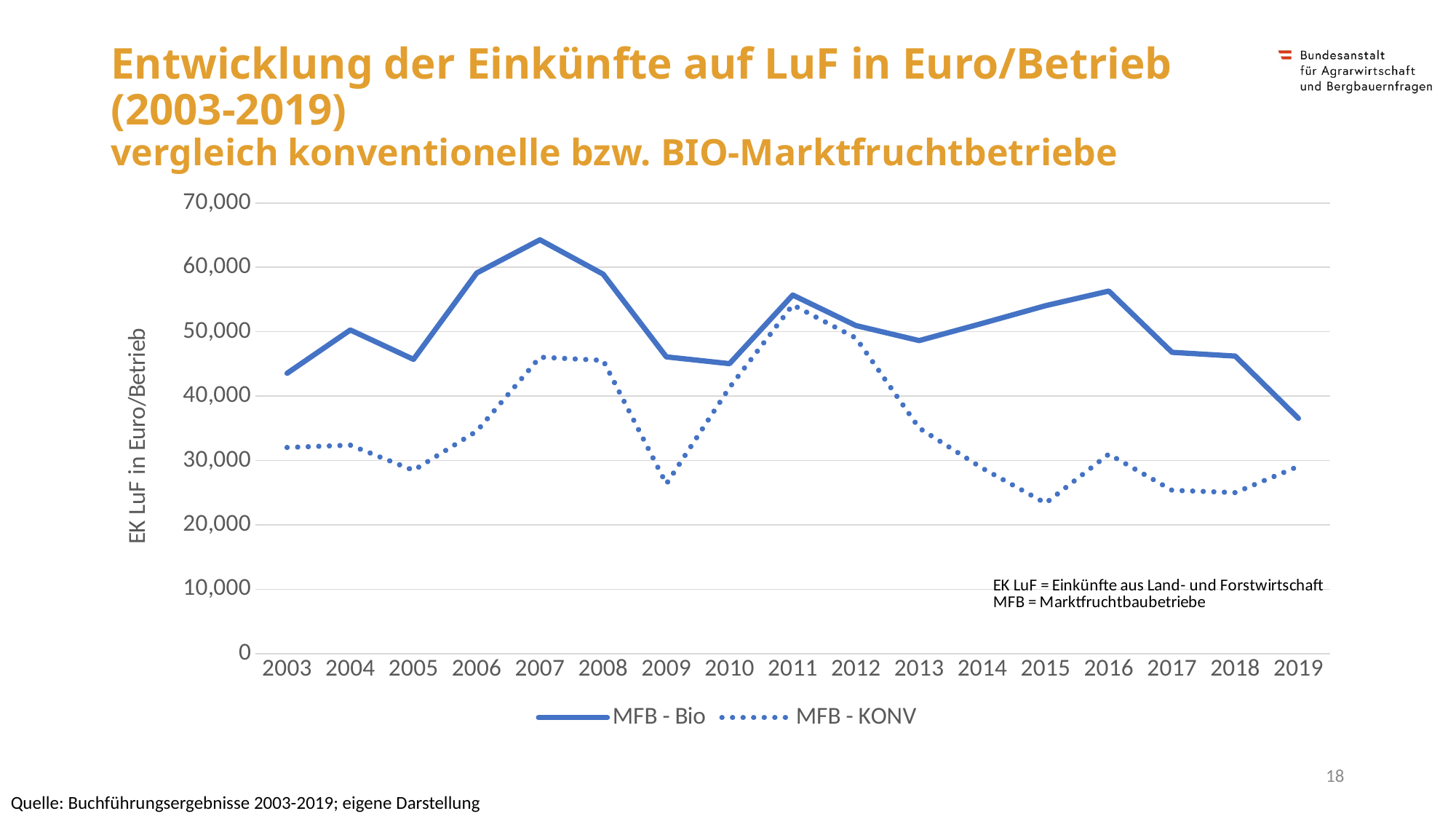
How many years are plotted along the x axis? 17 Is the value for MFB - KONV in 2009 greater or less than 30,000? less Is the value for MFB - Bio in 2007 greater or less than 60,000? greater What kind of chart is shown on the slide? Line chart In which year does the MFB - KONV series reach its lowest value? 2015 In which year does the MFB - Bio series reach its highest value? 2007 Does the MFB - Bio series rise or fall from 2016 to 2019? Fall Which series has the larger value in 2015, MFB - Bio or MFB - KONV? MFB - Bio In which year does the MFB - KONV series reach its highest value? 2011 How many series does the legend list? 2 What is the label of the y axis? EK LuF in Euro/Betrieb In which year does the MFB - Bio series reach its lowest value? 2019